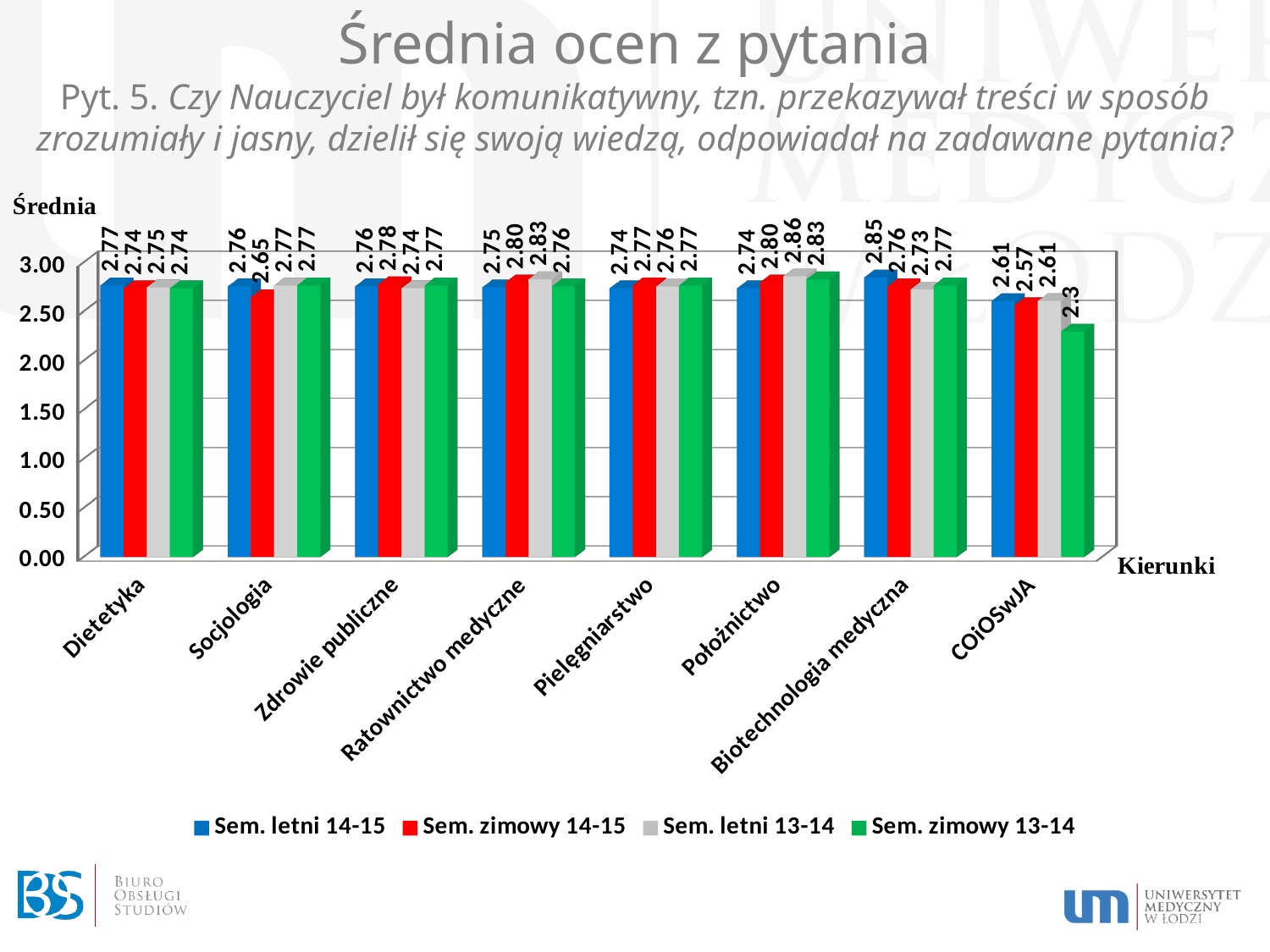
What is the difference between the Sem. letni 14-15 value and the Sem. zimowy 13-14 value for COiOSwJA? 0.31 What is the value for Położnictwo in the Sem. letni 13-14 series? 2.86 Which category has the lowest value in the Sem. zimowy 13-14 series? COiOSwJA Is the value for COiOSwJA in the Sem. zimowy 13-14 series greater or less than 2.50? less What is the value for Dietetyka in the Sem. letni 14-15 series? 2.77 Which category has the highest value in the Sem. letni 14-15 series? Biotechnologia medyczna How many series does the legend list? 4 What kind of chart is shown on the slide? Bar chart What is the value for Socjologia in the Sem. zimowy 14-15 series? 2.65 What is the value for COiOSwJA in the Sem. zimowy 13-14 series? 2.3 Which is larger for Ratownictwo medyczne: the Sem. letni 13-14 value or the Sem. zimowy 13-14 value? Sem. letni 13-14 How many categories (kierunki) are shown on the x axis? 8